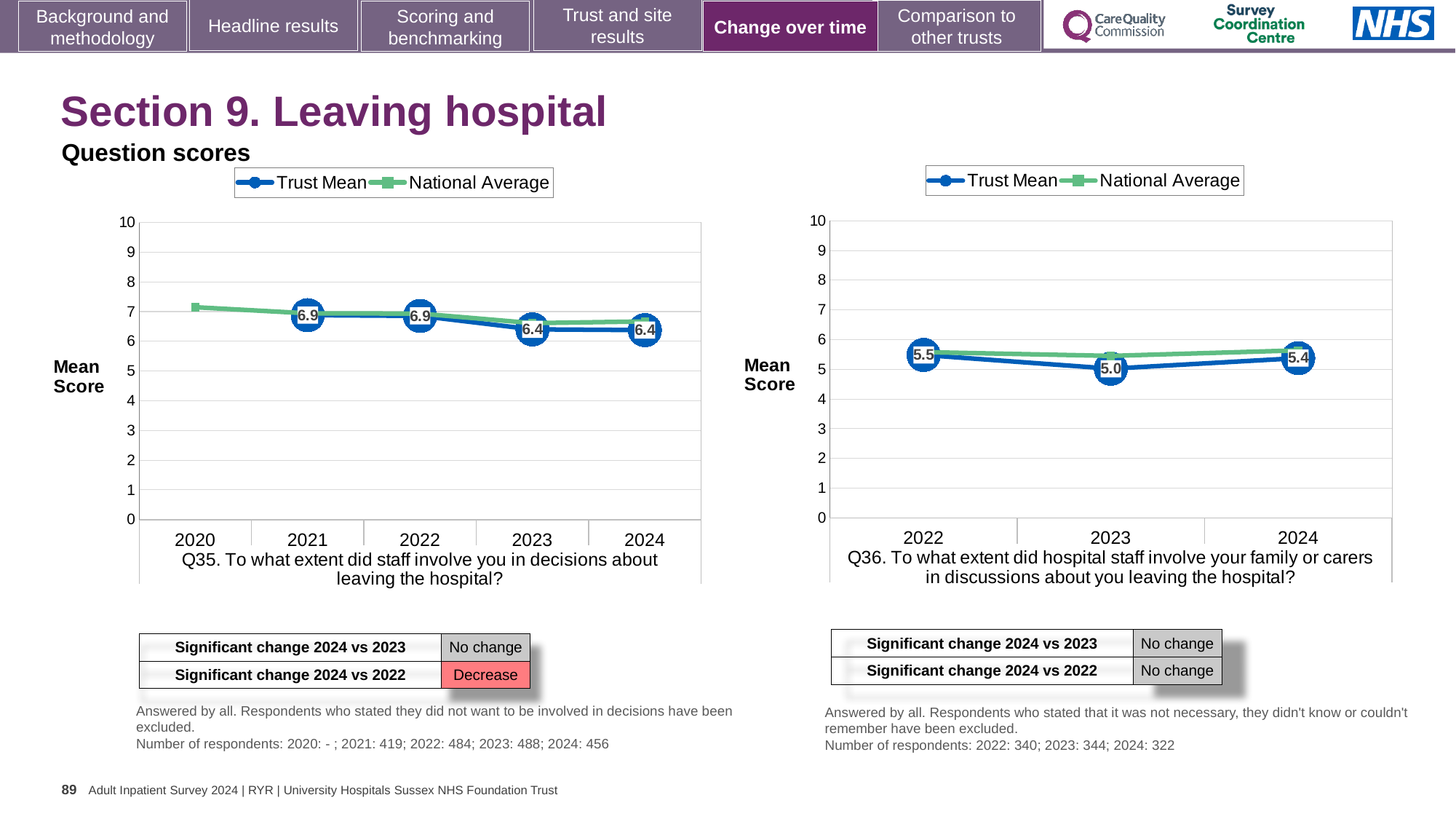
In the Q36 chart (right), what is the Trust Mean score for 2024? 5.4 In the Q36 chart (right), which year has the lowest Trust Mean score? 2023 In the Q35 chart (left), what is the Trust Mean score for 2024? 6.4 In the Q36 chart (right), what is the Trust Mean score for 2023? 5.0 In the Q35 chart (left), what is the difference between the Trust Mean scores for 2022 and 2024? 0.5 In the Q36 chart (right), which year has the highest Trust Mean score? 2022 In the Q35 chart (left), what is the Trust Mean score for 2021? 6.9 What type of chart is the Q35 chart (left)? Line chart How many series does the legend of the Q35 chart (left) list? 2 How many years are shown on the x axis of the Q36 chart (right)? 3 In the Q36 chart (right), what is the difference between the Trust Mean scores for 2022 and 2023? 0.5 In the Q35 chart (left), is the Trust Mean score for 2021 greater or less than 6? greater